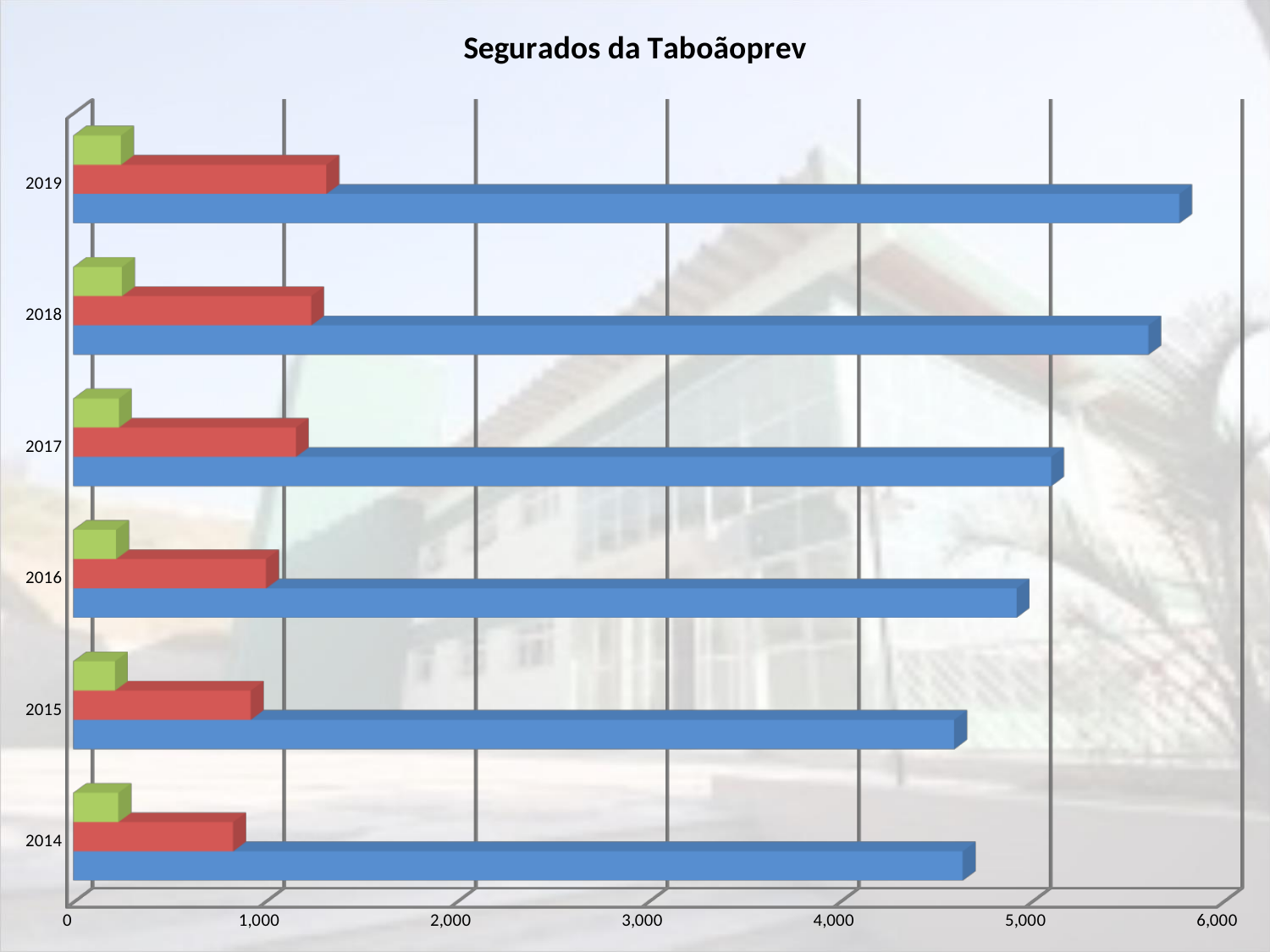
What is the title of the chart? Segurados da Taboãoprev Is the value of the blue bar for 2019 greater or less than 5,000? greater Do the blue bars generally rise or fall from 2014 to 2019? rise Is the value of the red bar for 2019 greater or less than 1,000? greater What kind of chart is shown on the slide? bar chart How many years are shown on the vertical axis of the chart? 6 Which year has the longest blue bar? 2019 Is the value of the red bar for 2014 greater or less than 1,000? less Which is larger, the blue bar for 2019 or the blue bar for 2017? 2019 Which is larger, the red bar for 2019 or the red bar for 2014? 2019